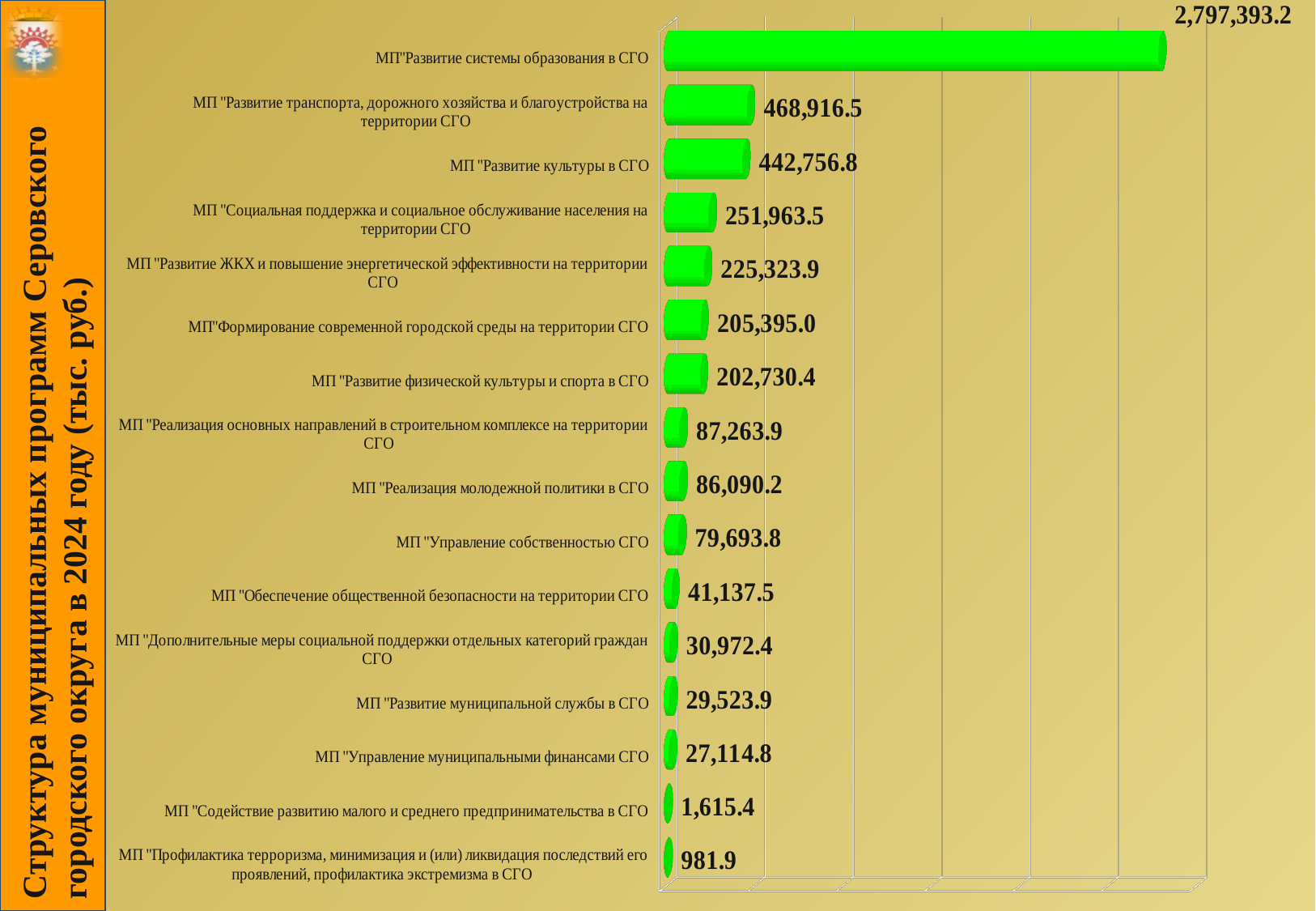
What is the value for МП "Управление собственностью СГО"? 79,693.8 How many municipal programs are shown in the chart? 16 What is the value for МП "Развитие физической культуры и спорта в СГО"? 202,730.4 What is the difference between the values for МП "Реализация основных направлений в строительном комплексе на территории СГО" and МП "Реализация молодежной политики в СГО"? 1,173.7 Which municipal program has the lowest value? МП "Профилактика терроризма, минимизация и (или) ликвидация последствий его проявлений, профилактика экстремизма в СГО" Which is larger: the value for МП "Развитие муниципальной службы в СГО" or МП "Управление муниципальными финансами СГО"? МП "Развитие муниципальной службы в СГО" What is the value for МП "Развитие культуры в СГО"? 442,756.8 What is the value for МП "Содействие развитию малого и среднего предпринимательства в СГО"? 1,615.4 What is the difference between the values for МП "Развитие транспорта, дорожного хозяйства и благоустройства на территории СГО" and МП "Развитие культуры в СГО"? 26,159.7 What type of chart is shown on the slide? Bar chart Which municipal program has the highest value? МП "Развитие системы образования в СГО" What is the title of the chart on the slide? Структура муниципальных программ Серовского городского округа в 2024 году (тыс. руб.)